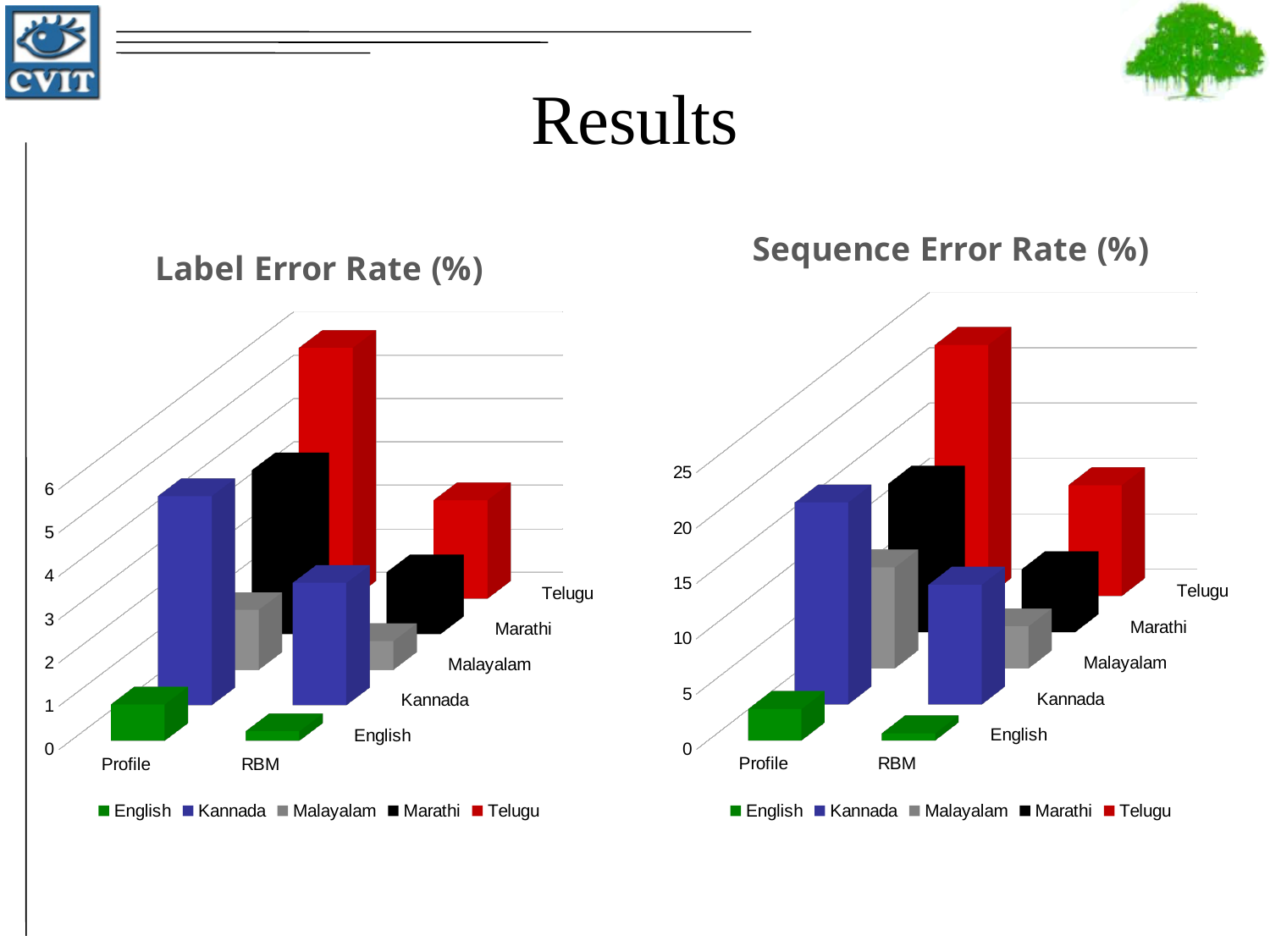
In the Label Error Rate (%) chart, is the Kannada value larger for Profile or for RBM? Profile What are the two categories on the x axis of the Sequence Error Rate (%) chart? Profile and RBM In the Sequence Error Rate (%) chart, is the value for English under RBM greater or less than 5? less Which colour represents Malayalam in the legend of the Label Error Rate (%) chart? grey How many categories are shown on the x axis of the Label Error Rate (%) chart? 2 In the Sequence Error Rate (%) chart, is the value for Kannada under Profile greater or less than 10? greater In the Sequence Error Rate (%) chart, is the Telugu value larger for Profile or for RBM? Profile In the Label Error Rate (%) chart, do the Marathi values rise or fall from Profile to RBM? fall What type of chart is the Label Error Rate (%) chart? bar chart How many series does the legend of the Sequence Error Rate (%) chart list? 5 In the Label Error Rate (%) chart, which series has the highest value for Profile? Telugu In the Sequence Error Rate (%) chart, which series has the lowest value for RBM? English